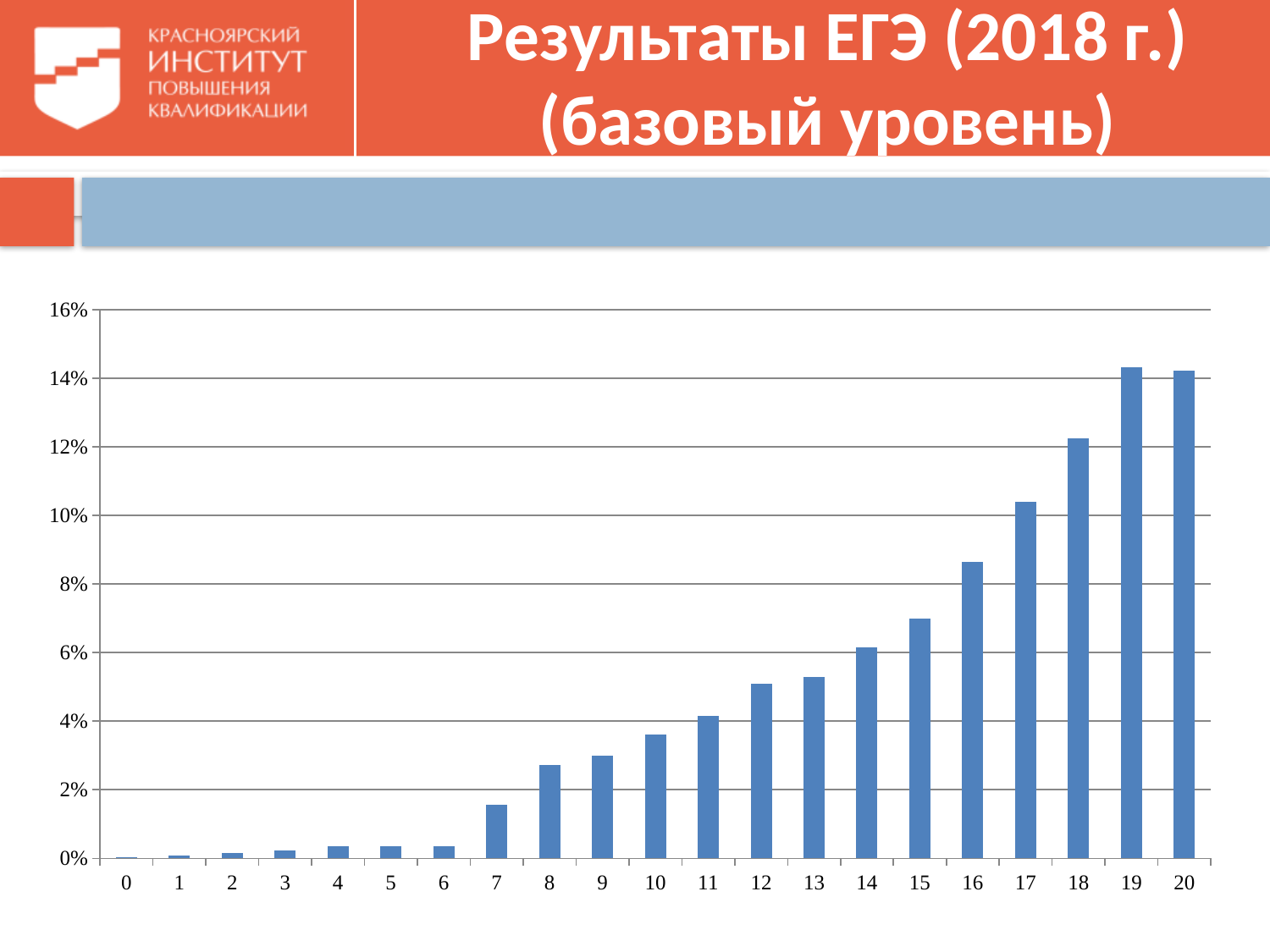
Is the value for category 15 greater or less than 8%? less Which has the larger value, category 18 or category 17? 18 What is the title of the slide containing the chart? Результаты ЕГЭ (2018 г.) (базовый уровень) Do the values generally rise or fall as the x axis goes from 0 to 20? rise Which category has the lowest value in the chart? 0 Which has the larger value, category 8 or category 7? 8 Is the value for category 7 greater or less than 2%? less How many categories are shown along the x axis of the chart? 21 Is the value for category 18 greater or less than 12%? greater What kind of chart is shown on the slide? bar chart